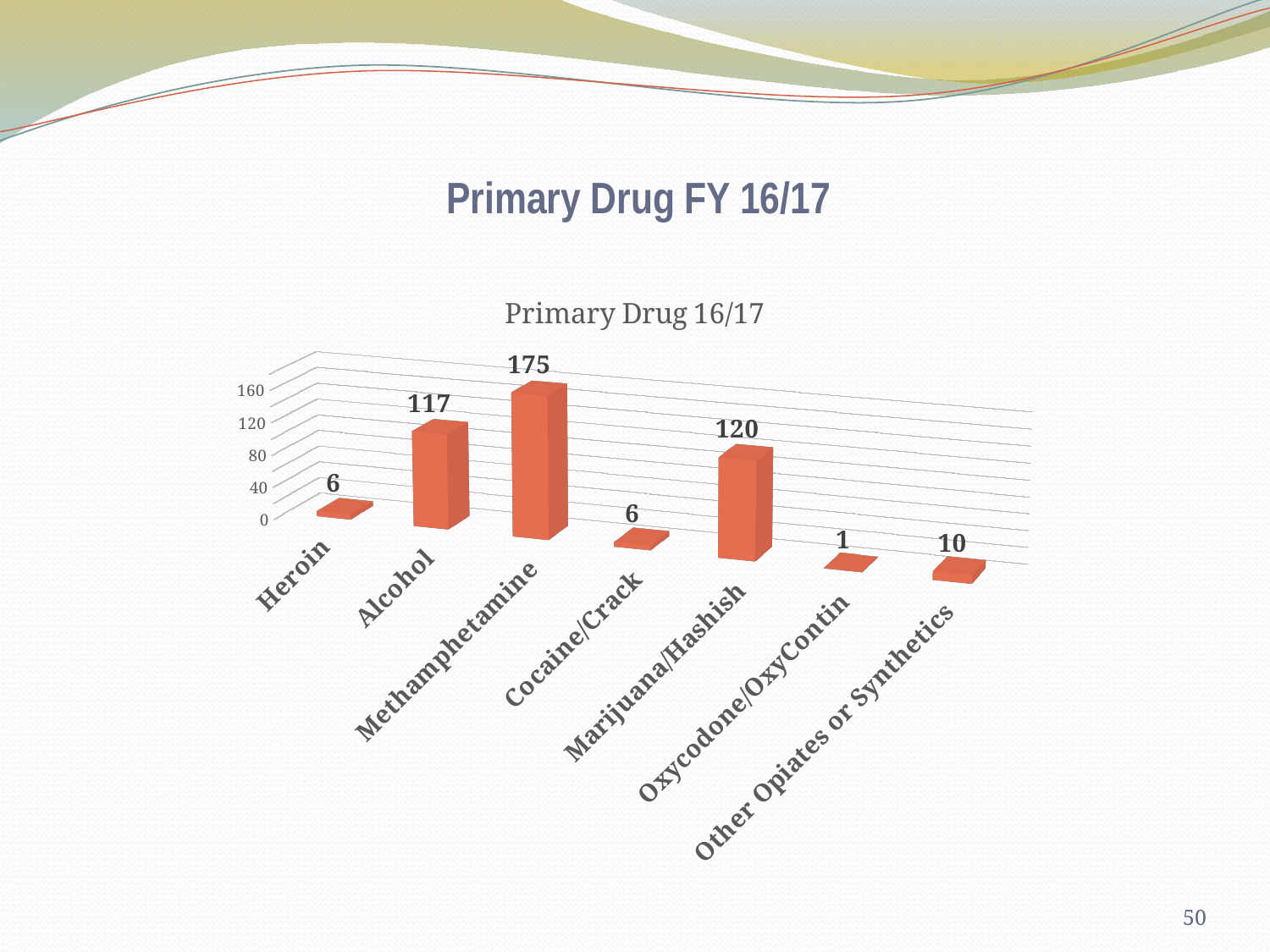
How many categories are shown on the x axis? 7 Which is larger, the value for Alcohol or the value for Marijuana/Hashish? Marijuana/Hashish What is the value for Marijuana/Hashish? 120 What is the title of the chart? Primary Drug 16/17 What is the value for Methamphetamine? 175 What kind of chart is shown on the slide? Bar chart What is the difference between the values for Methamphetamine and Marijuana/Hashish? 55 What is the value for Oxycodone/OxyContin? 1 What is the value for Alcohol? 117 What is the value for Other Opiates or Synthetics? 10 Which category has the highest value? Methamphetamine Which category has the lowest value? Oxycodone/OxyContin